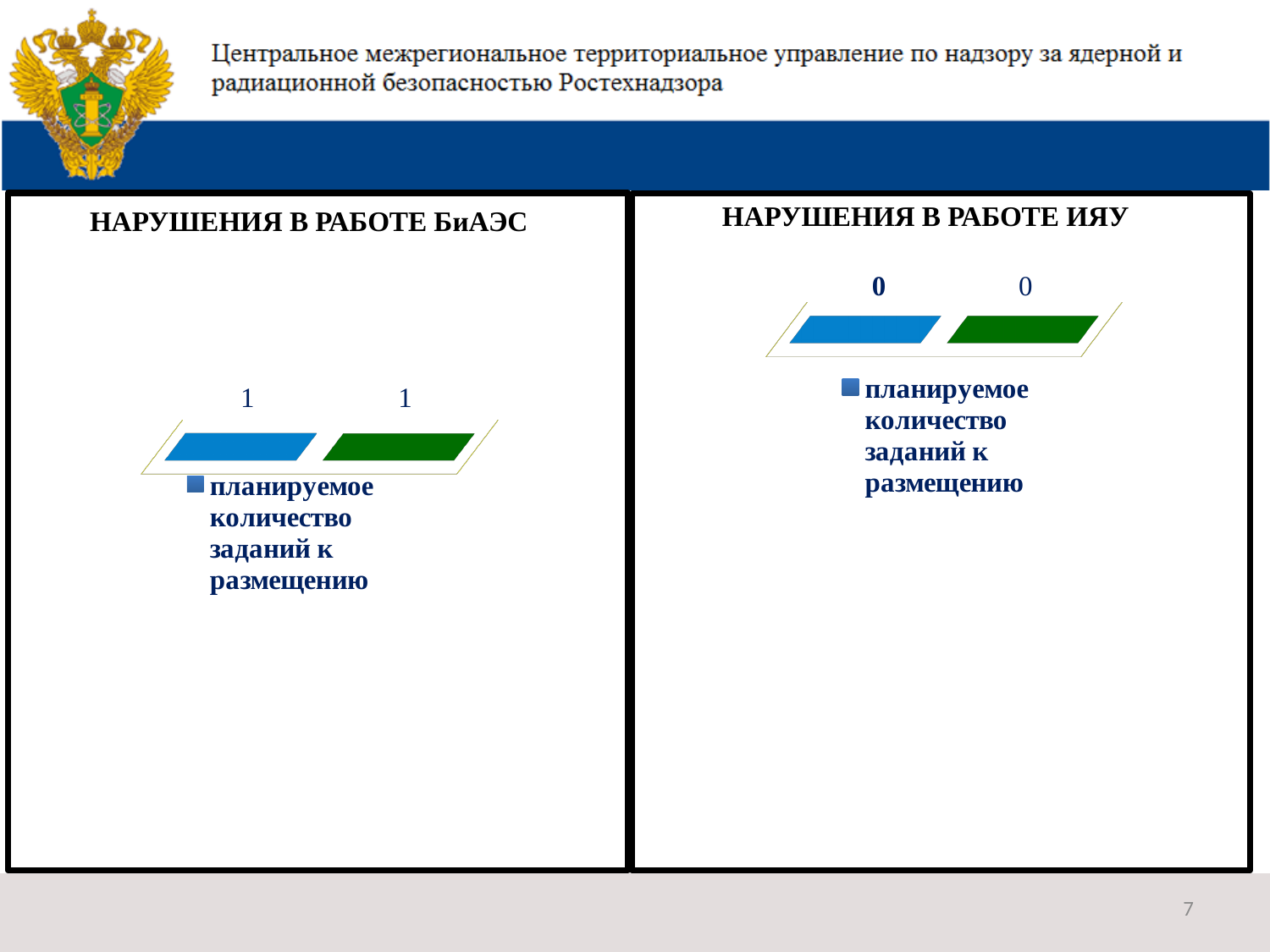
In the chart titled "НАРУШЕНИЯ В РАБОТЕ БиАЭС", what value is shown on the green bar? 1 In the chart titled "НАРУШЕНИЯ В РАБОТЕ ИЯУ", how many bars are plotted? 2 In the chart titled "НАРУШЕНИЯ В РАБОТЕ ИЯУ", what is the legend entry? планируемое количество заданий к размещению In the chart titled "НАРУШЕНИЯ В РАБОТЕ БиАЭС", how many bars are plotted? 2 In the chart titled "НАРУШЕНИЯ В РАБОТЕ БиАЭС", what value is shown on the blue bar? 1 In the chart titled "НАРУШЕНИЯ В РАБОТЕ ИЯУ", what value is shown on the green bar? 0 What is the title of the chart in the left-hand panel of the slide? НАРУШЕНИЯ В РАБОТЕ БиАЭС What kind of chart is shown in the right-hand panel titled "НАРУШЕНИЯ В РАБОТЕ ИЯУ"? Bar chart In the chart titled "НАРУШЕНИЯ В РАБОТЕ БиАЭС", what is the difference between the values on the blue bar and the green bar? 0 In the chart titled "НАРУШЕНИЯ В РАБОТЕ ИЯУ", what value is shown on the blue bar? 0 In the chart titled "НАРУШЕНИЯ В РАБОТЕ ИЯУ", what is the total of the two values shown? 0 In the chart titled "НАРУШЕНИЯ В РАБОТЕ БиАЭС", how many entries does the legend list? 1